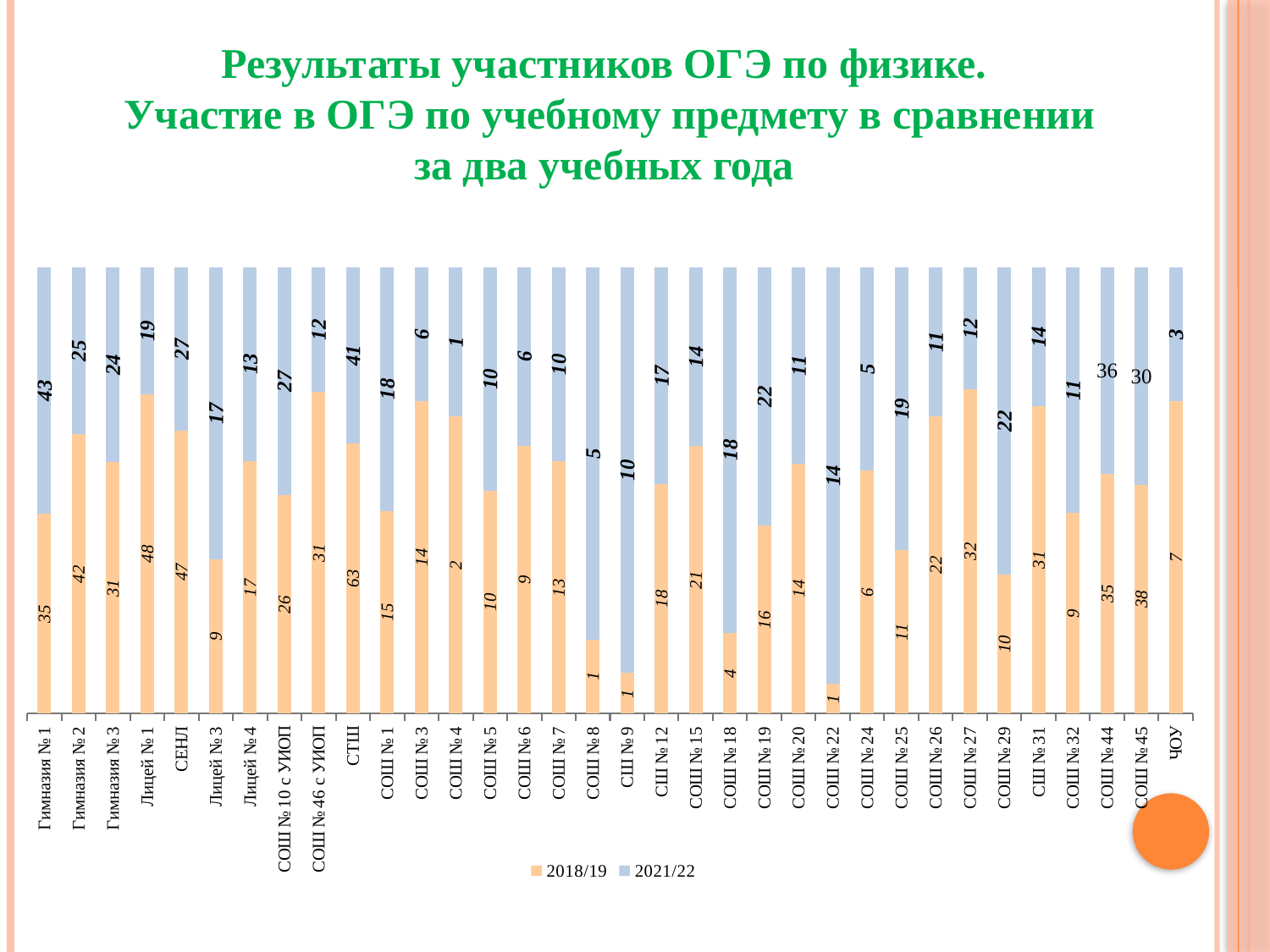
What is the 2018/19 value for СТШ? 63 Which series is shown in orange in the legend? 2018/19 Which school has the highest 2018/19 value? СТШ How many series does the legend list? 2 Which school has the lowest 2021/22 value? СОШ №4 What kind of chart is shown on the slide? bar chart Which is larger for СОШ №18: the 2018/19 value or the 2021/22 value? 2021/22 How many schools (categories) are shown on the x axis? 34 What is the difference between the 2018/19 and 2021/22 values for Лицей №1? 29 What is the 2021/22 value for Гимназия №1? 43 What is the 2018/19 value for СОШ №27? 32